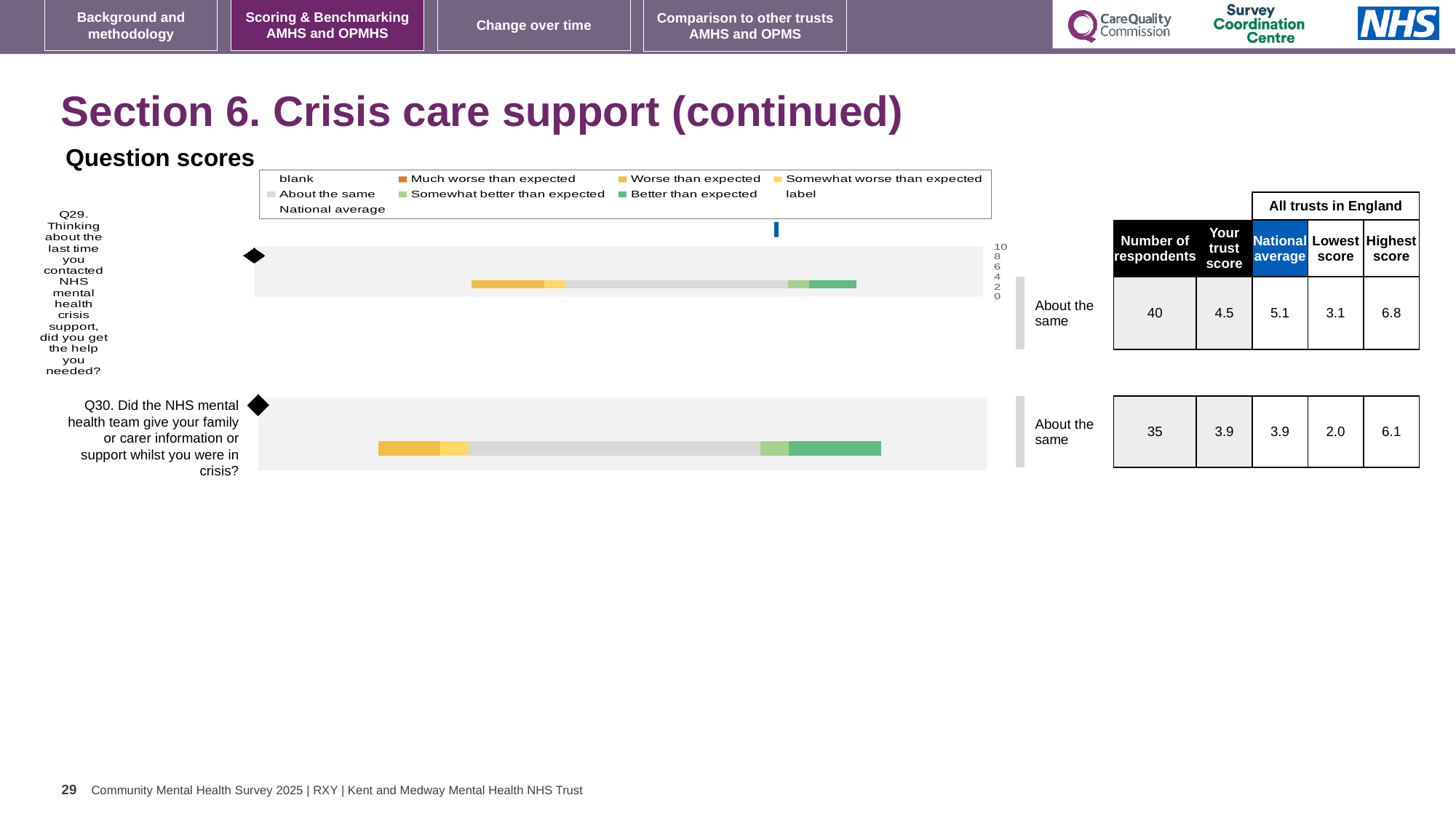
How many more respondents answered Q29 than Q30? 5 What is the national average for Q29? 5.1 How many questions are plotted in the question scores chart? 2 For Q29, which is larger: the trust score or the national average? national average What is the highest score among all trusts in England for Q30? 6.1 What is the difference between the highest score and the lowest score for Q29? 3.7 How many respondents answered Q30? 35 What kind of chart is used to show the question scores for Q29 and Q30? bar chart What is the trust score for Q29 shown in the table next to the chart? 4.5 What is the lowest score among all trusts in England for Q30? 2.0 What colour represents 'Better than expected' in the chart legend? green What benchmark category is shown for Q29 next to the chart? About the same